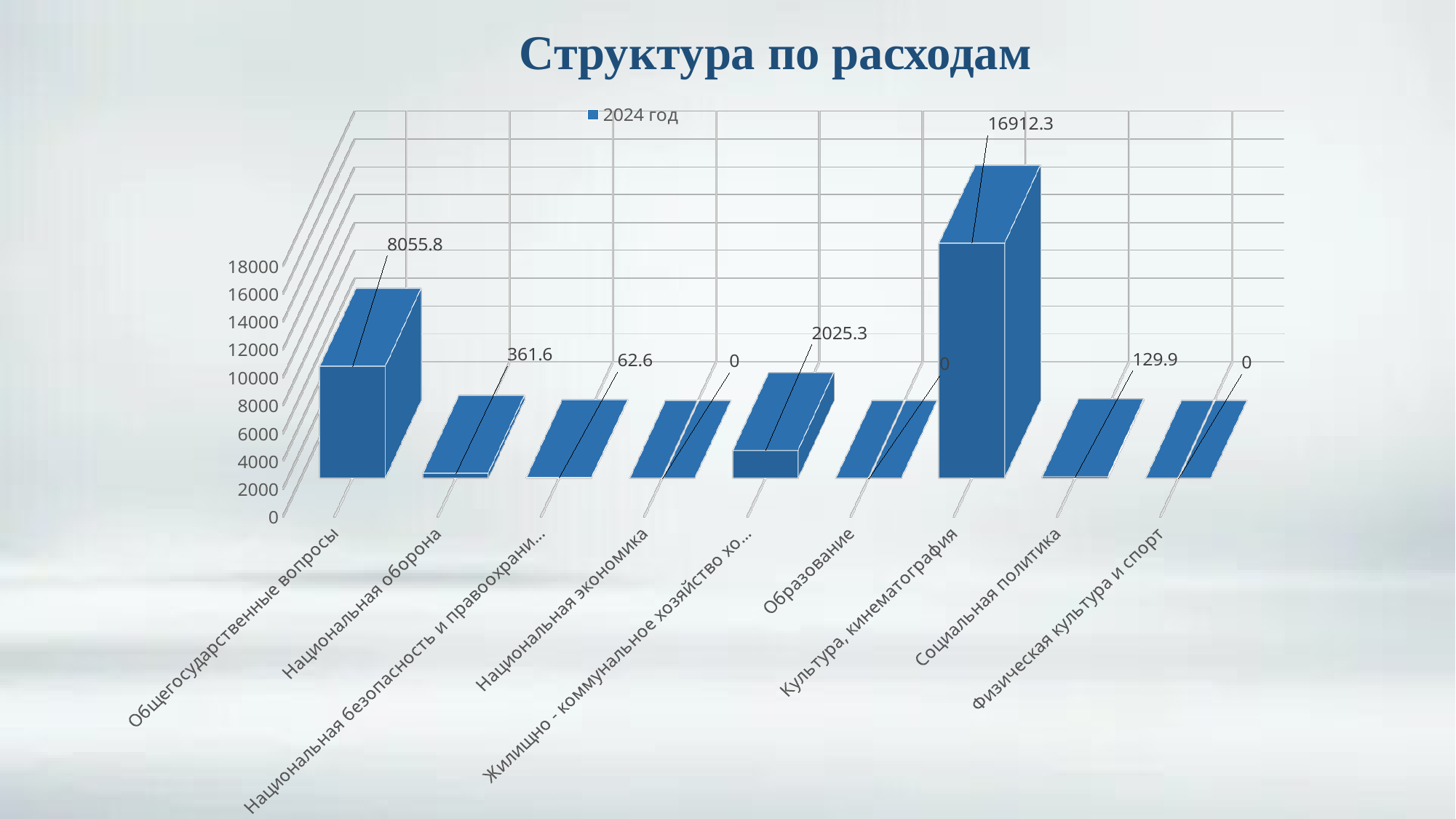
What is the value for Социальная политика? 129.9 How many categories are shown on the x axis? 9 What is the value for Общегосударственные вопросы? 8055.8 Which is larger, the value for Общегосударственные вопросы or the value for Национальная оборона? Общегосударственные вопросы How many series does the legend list? 1 What is the value for Культура, кинематография? 16912.3 What kind of chart is shown on the slide? Bar chart What is the value for Национальная оборона? 361.6 Which category has the highest value? Культура, кинематография What is the difference between the values for Культура, кинематография and Общегосударственные вопросы? 8856.5 What is the value for Национальная экономика? 0 What is the difference between the values for Национальная оборона and Социальная политика? 231.7